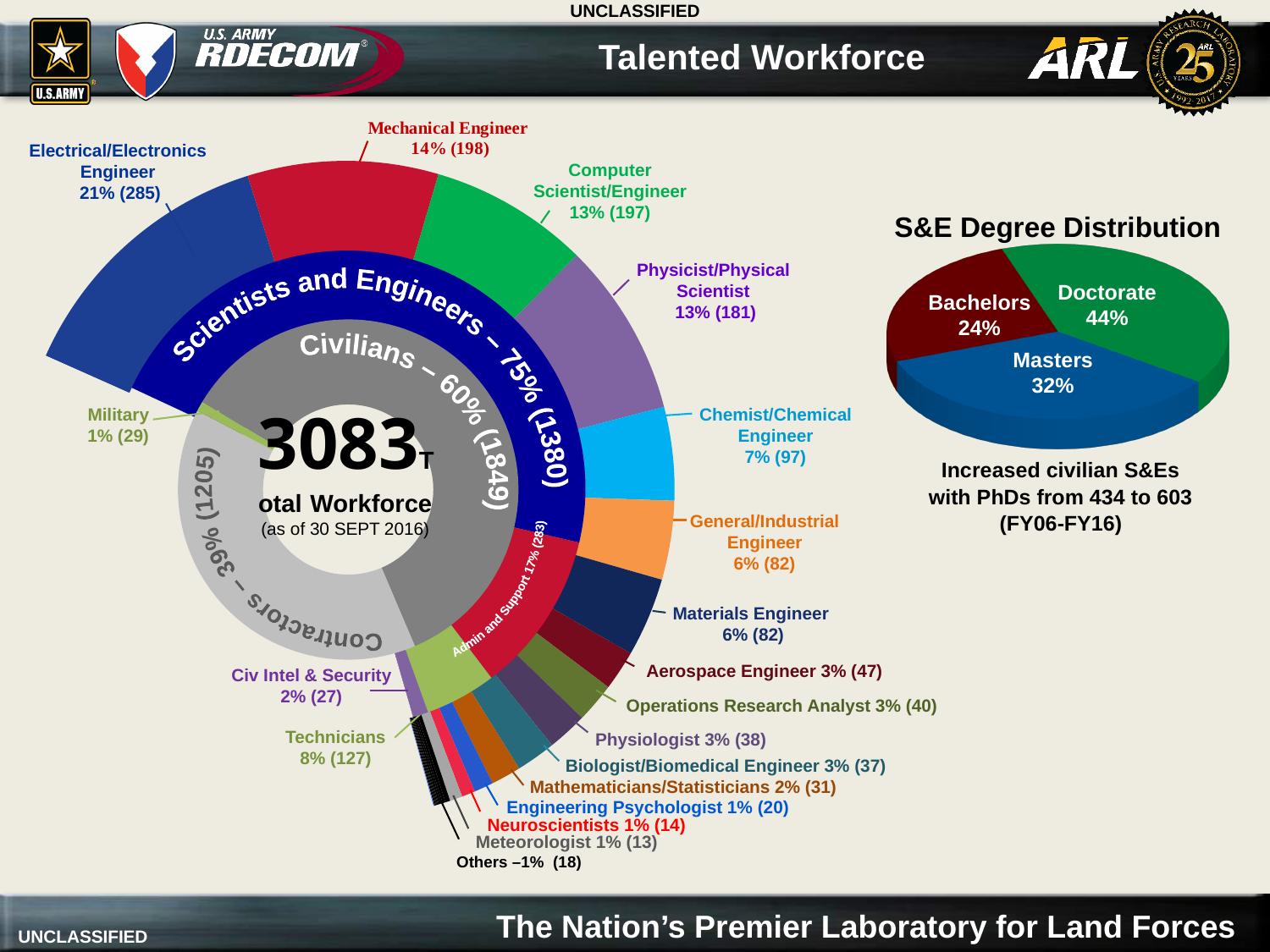
In the S&E Degree Distribution chart, which degree level has the largest share? Doctorate In the workforce chart on the left, what percentage of the workforce is Military? 1% In the workforce chart on the left, which group is larger: Chemist/Chemical Engineer or Materials Engineer? Chemist/Chemical Engineer In the S&E Degree Distribution chart, which degree level has the smallest share? Bachelors In the S&E Degree Distribution chart, what share of the pie is Doctorate? 44% In the workforce chart on the left, how many Electrical/Electronics Engineers are there? 285 How many slices does the S&E Degree Distribution pie chart have? 3 What kind of chart is the S&E Degree Distribution chart? Pie chart In the workforce chart on the left, what percentage of the workforce are Civilians? 60% In the S&E Degree Distribution chart, how many percentage points larger is the Doctorate share than the Bachelors share? 20 percentage points In the workforce chart on the left, how many Contractors are there? 1205 In the workforce chart on the left, what is the total workforce shown in the centre? 3083